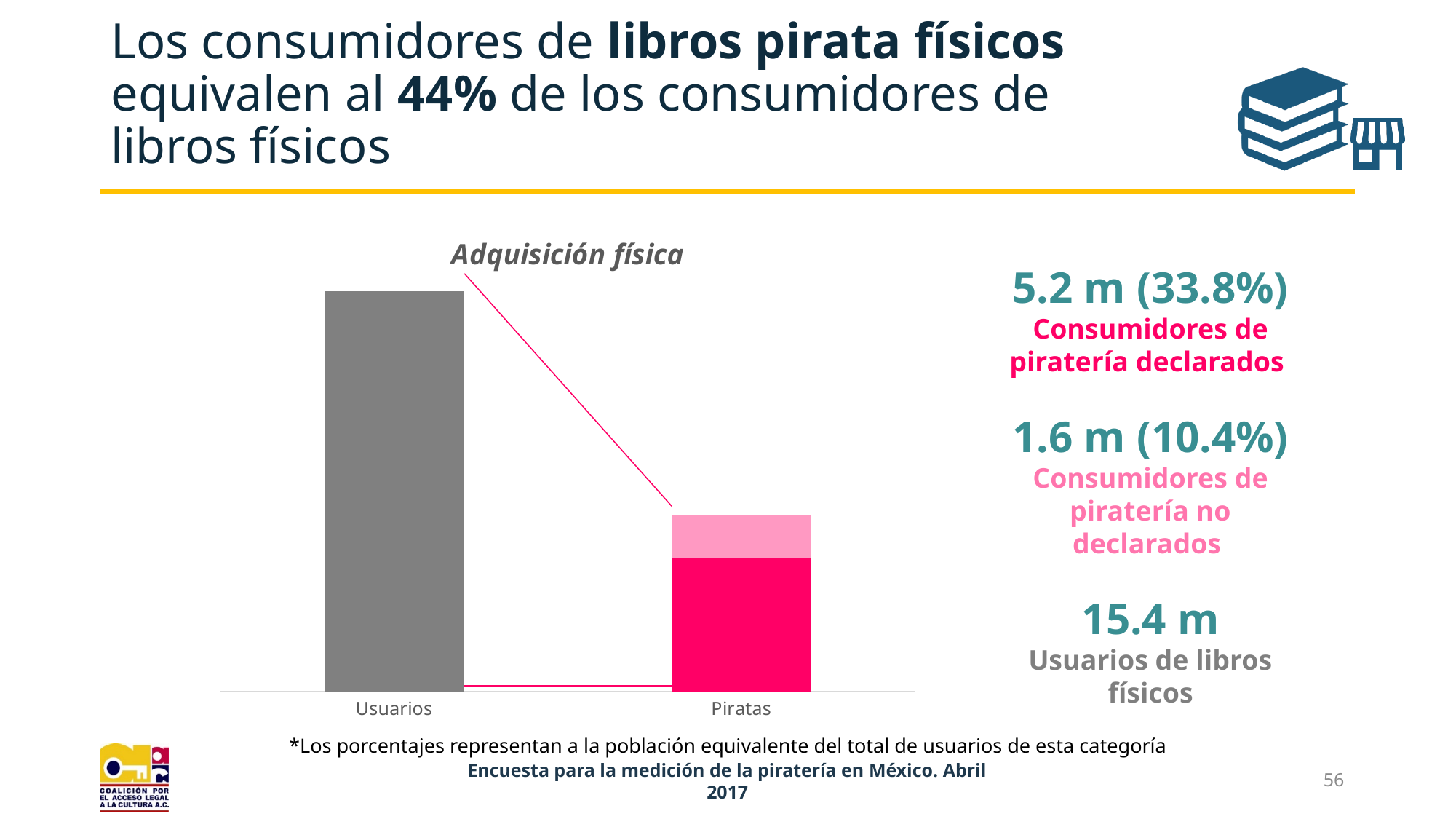
Which category has the shortest bar in the chart? Piratas Which category has the tallest bar in the chart? Usuarios How many categories are shown on the x axis of the chart? 2 How many users of physical books (Usuarios de libros físicos) are reported on the slide? 15.4 m Which bar is taller, Usuarios or Piratas? Usuarios What is the title of the chart? Adquisición física What value is given for non-declared piracy consumers (Consumidores de piratería no declarados)? 1.6 m (10.4%) What colour is the Usuarios bar? gray What value is given for declared piracy consumers (Consumidores de piratería declarados)? 5.2 m (33.8%) What is the difference between declared piracy consumers (5.2 m) and non-declared piracy consumers (1.6 m)? 3.6 m What kind of chart is shown on the slide? bar chart What is the total of the Piratas stacked bar, adding declared (5.2 m) and non-declared (1.6 m) piracy consumers? 6.8 m